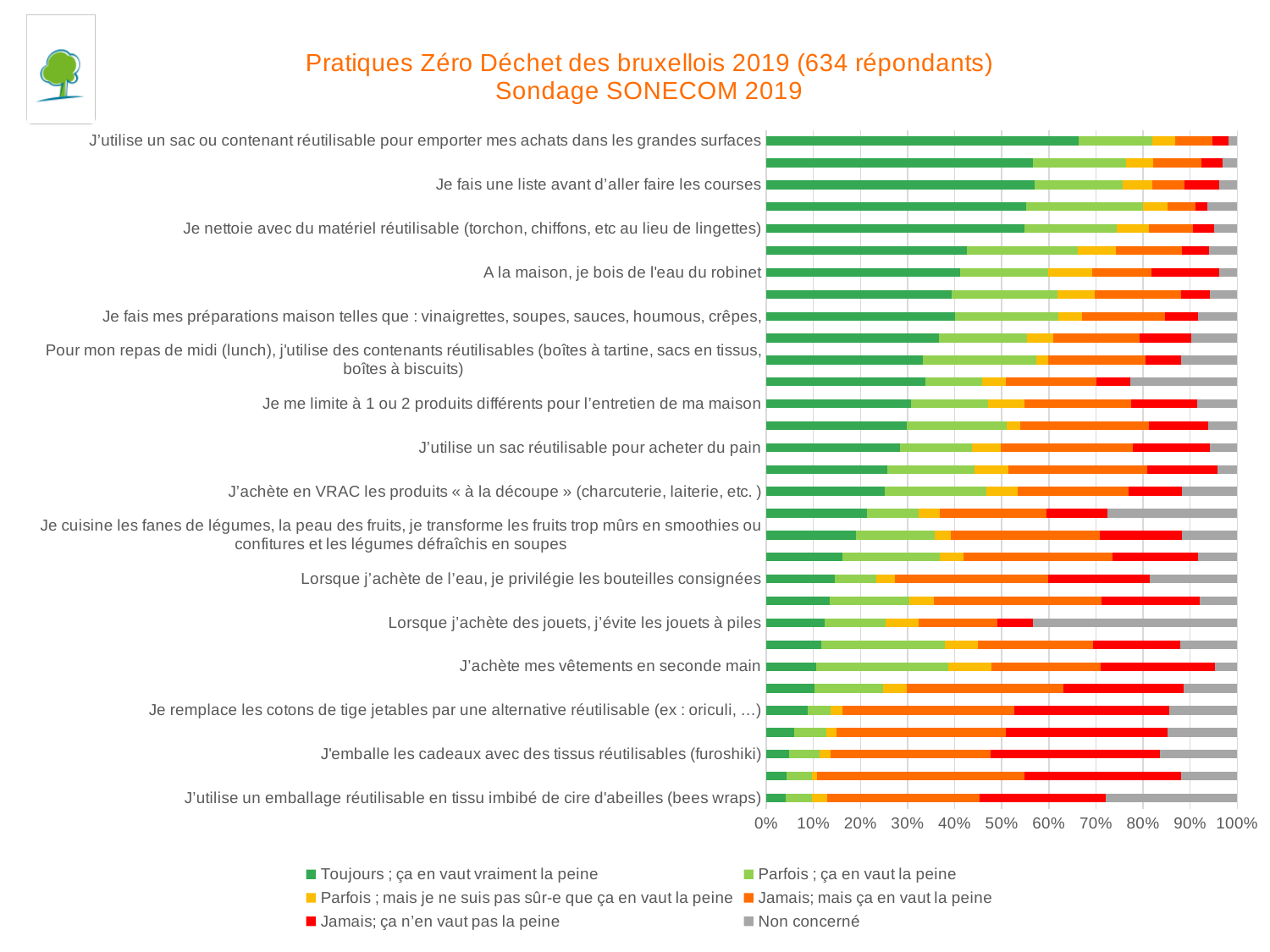
How many series does the legend list? 6 Is the 'Toujours ; ça en vaut vraiment la peine' share for 'J'utilise un sac ou contenant réutilisable pour emporter mes achats dans les grandes surfaces' greater or less than 60%? greater Is the 'Toujours ; ça en vaut vraiment la peine' share for 'Lorsque j'achète de l'eau, je privilégie les bouteilles consignées' greater or less than 20%? less Which practice has the highest share of 'Toujours ; ça en vaut vraiment la peine'? J'utilise un sac ou contenant réutilisable pour emporter mes achats dans les grandes surfaces How many respondents does the chart title say took part in the survey? 634 Going from the top of the chart to the bottom, do the 'Toujours ; ça en vaut vraiment la peine' shares generally increase or decrease? decrease Which has a larger 'Toujours ; ça en vaut vraiment la peine' share: 'Je fais une liste avant d'aller faire les courses' or 'A la maison, je bois de l'eau du robinet'? Je fais une liste avant d'aller faire les courses Which has a larger 'Non concerné' share: 'Lorsque j'achète des jouets, j'évite les jouets à piles' or 'J'achète mes vêtements en seconde main'? Lorsque j'achète des jouets, j'évite les jouets à piles Is the 'Toujours ; ça en vaut vraiment la peine' share for 'J'utilise un emballage réutilisable en tissu imbibé de cire d'abeilles (bees wraps)' greater or less than 10%? less What colour represents 'Non concerné' in the legend? grey What kind of chart is shown on the slide? bar chart